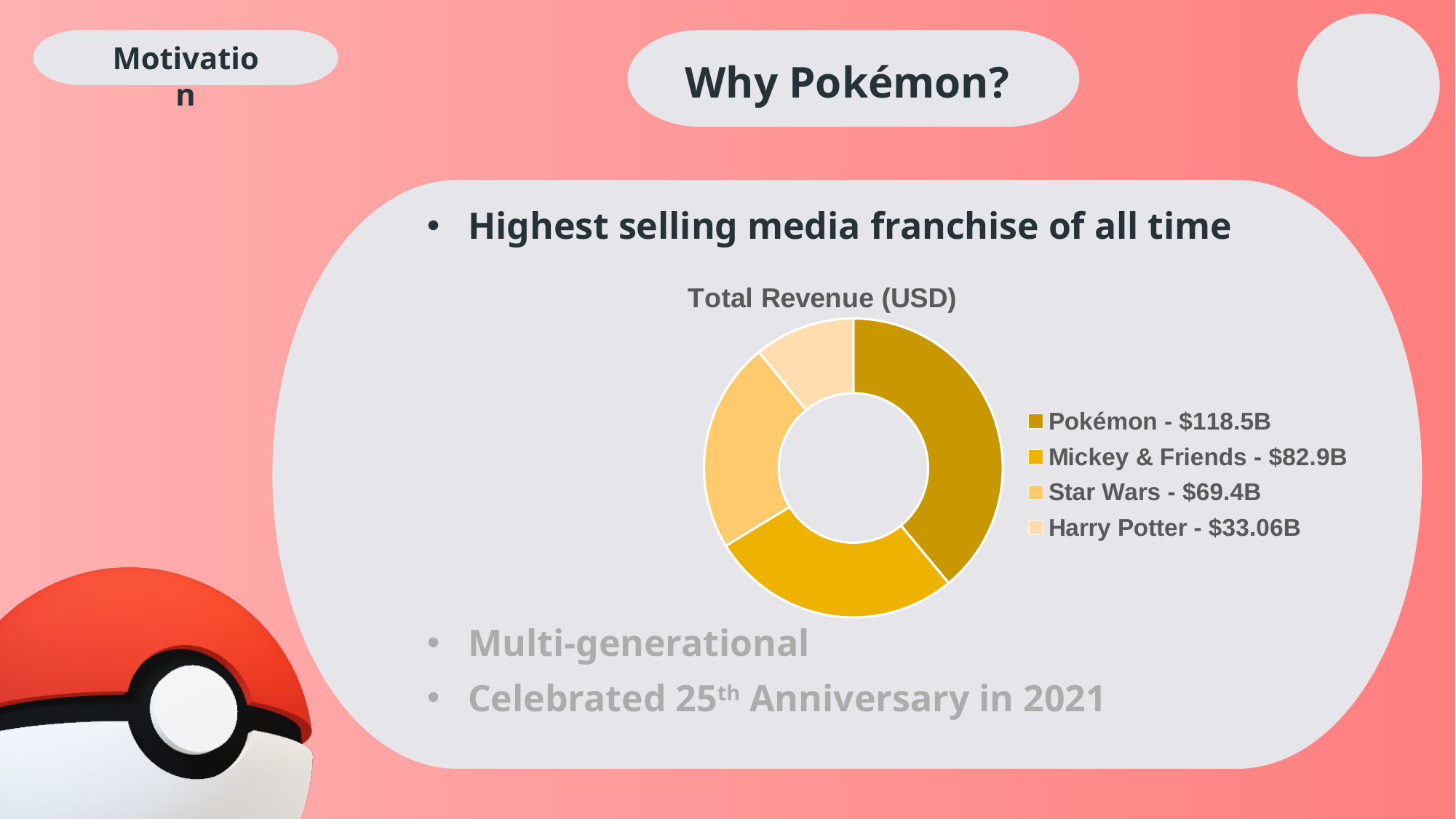
What is the total revenue shown for Mickey & Friends? $82.9B What is the total revenue shown for Pokémon? $118.5B Which franchise has the lowest total revenue in the chart? Harry Potter Which has the larger total revenue, Star Wars or Mickey & Friends? Mickey & Friends What is the total revenue shown for Harry Potter? $33.06B How many franchises are shown in the chart? 4 What is the total revenue shown for Star Wars? $69.4B What is the title of the chart? Total Revenue (USD) What is the difference in total revenue between Pokémon and Mickey & Friends? $35.6B What kind of chart is shown on the slide? doughnut chart What is the combined total revenue of all four franchises in the chart? $303.86B Which franchise has the highest total revenue in the chart? Pokémon